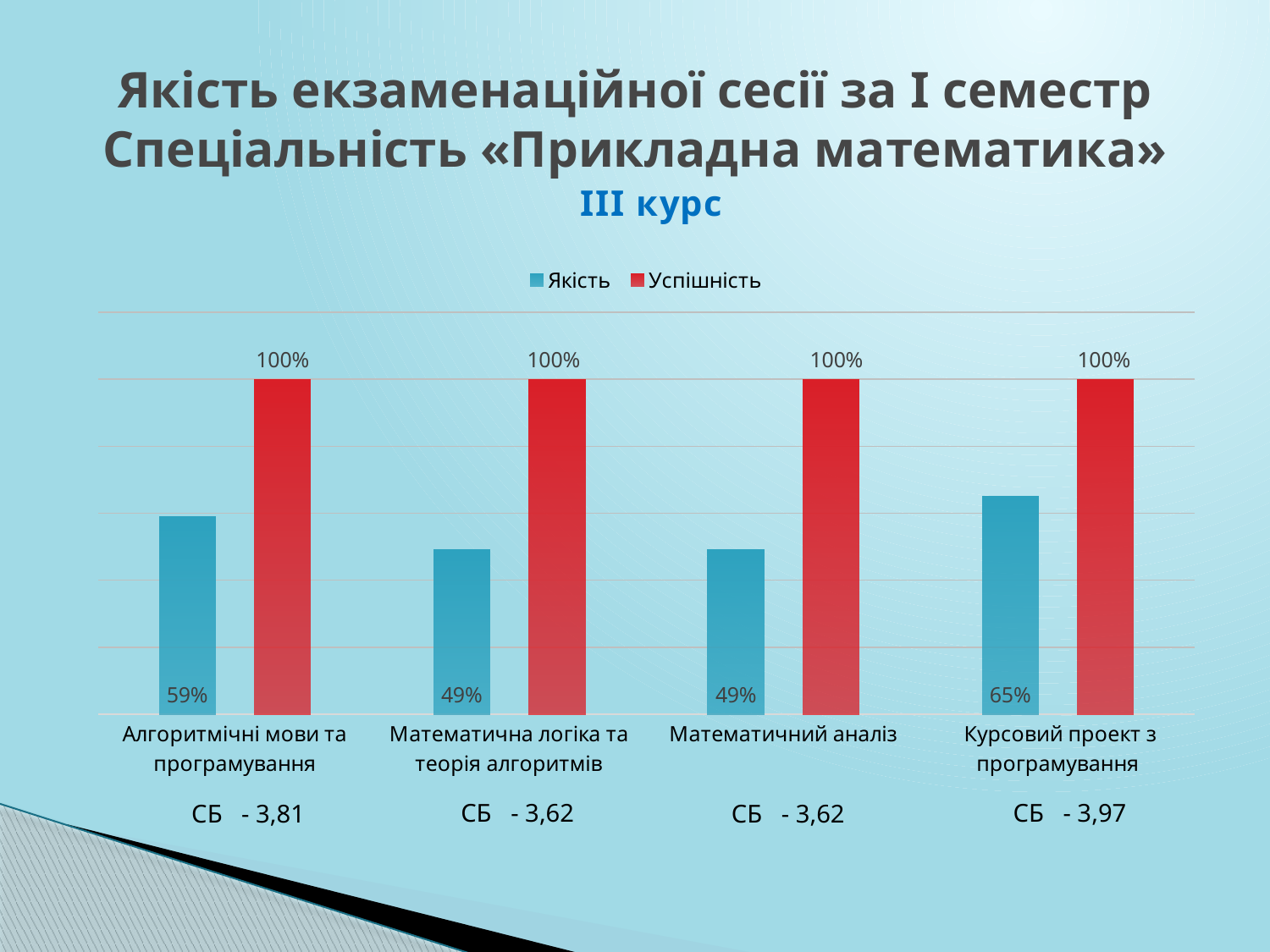
How many categories are shown on the x axis? 4 What kind of chart is shown on the slide? Bar chart Which is larger, the Якість value for Алгоритмічні мови та програмування or for Математична логіка та теорія алгоритмів? Алгоритмічні мови та програмування What is the difference between the Якість values for Курсовий проект з програмування and Алгоритмічні мови та програмування? 6% What is the Якість value for Математична логіка та теорія алгоритмів? 49% What is the Успішність value for Математичний аналіз? 100% How many series does the legend list? 2 Which category has the highest Якість value? Курсовий проект з програмування What is the difference between the Успішність and Якість values for Математичний аналіз? 51% What is the Якість value for Курсовий проект з програмування? 65% Which series is shown in red in the legend? Успішність What is the Якість value for Алгоритмічні мови та програмування? 59%